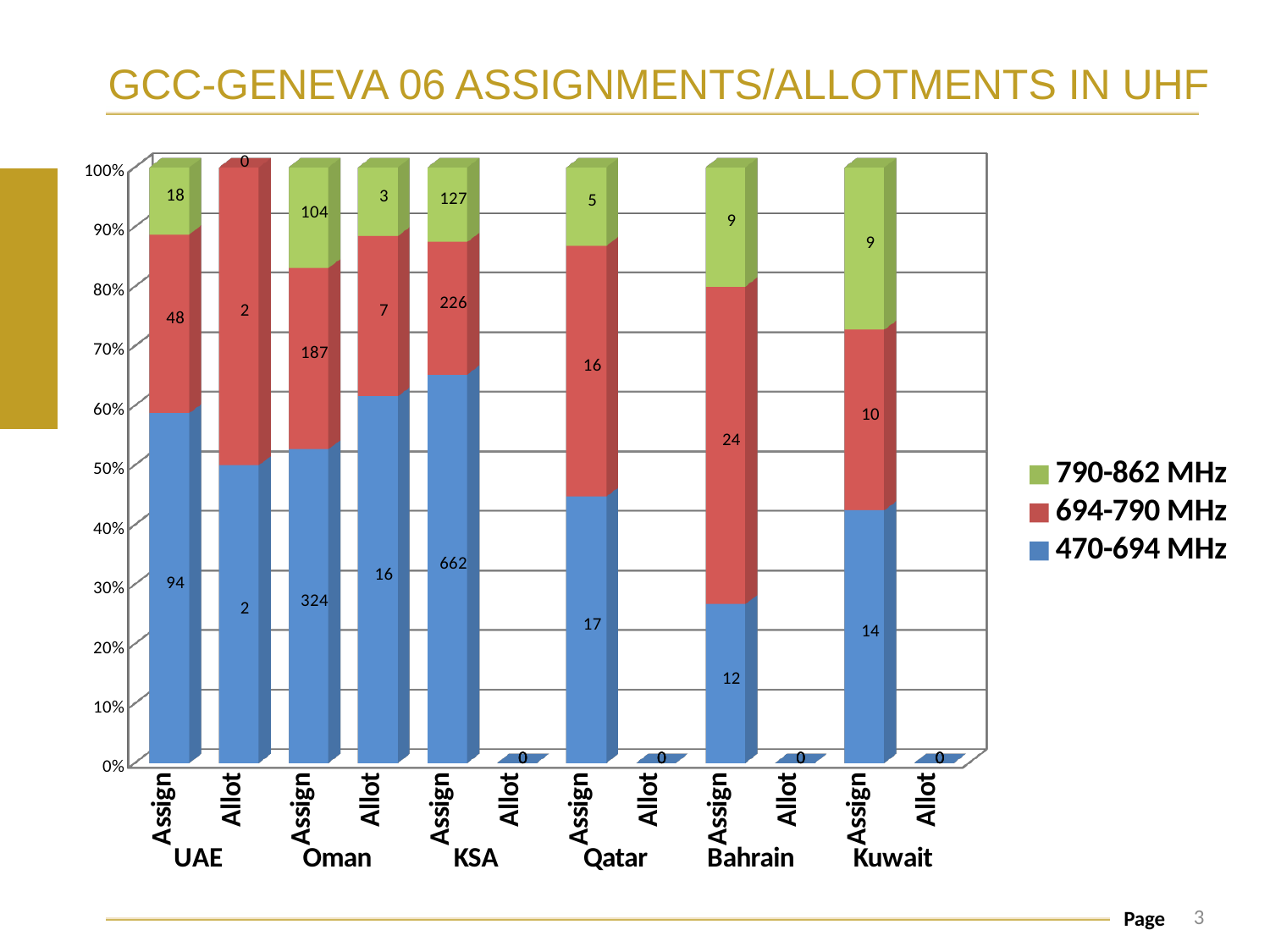
What is the value of the 790-862 MHz series for the Oman Assign bar? 104 What kind of chart is shown on the slide? Stacked bar chart Which frequency band does the green series in the legend represent? 790-862 MHz What is the total of the three series for the Kuwait Assign bar? 33 How many bars (Assign/Allot categories) are shown on the x axis? 12 Which is larger: the 470-694 MHz value for Qatar Assign or for Kuwait Assign? Qatar Assign What is the value of the 694-790 MHz series for the Bahrain Assign bar? 24 Which bar has the highest 470-694 MHz value? KSA Assign What is the total of the three series for the UAE Assign bar? 160 What is the value of the 470-694 MHz series for the KSA Assign bar? 662 How many series does the legend list? 3 What is the difference between the 694-790 MHz values for the Oman Assign and UAE Assign bars? 139